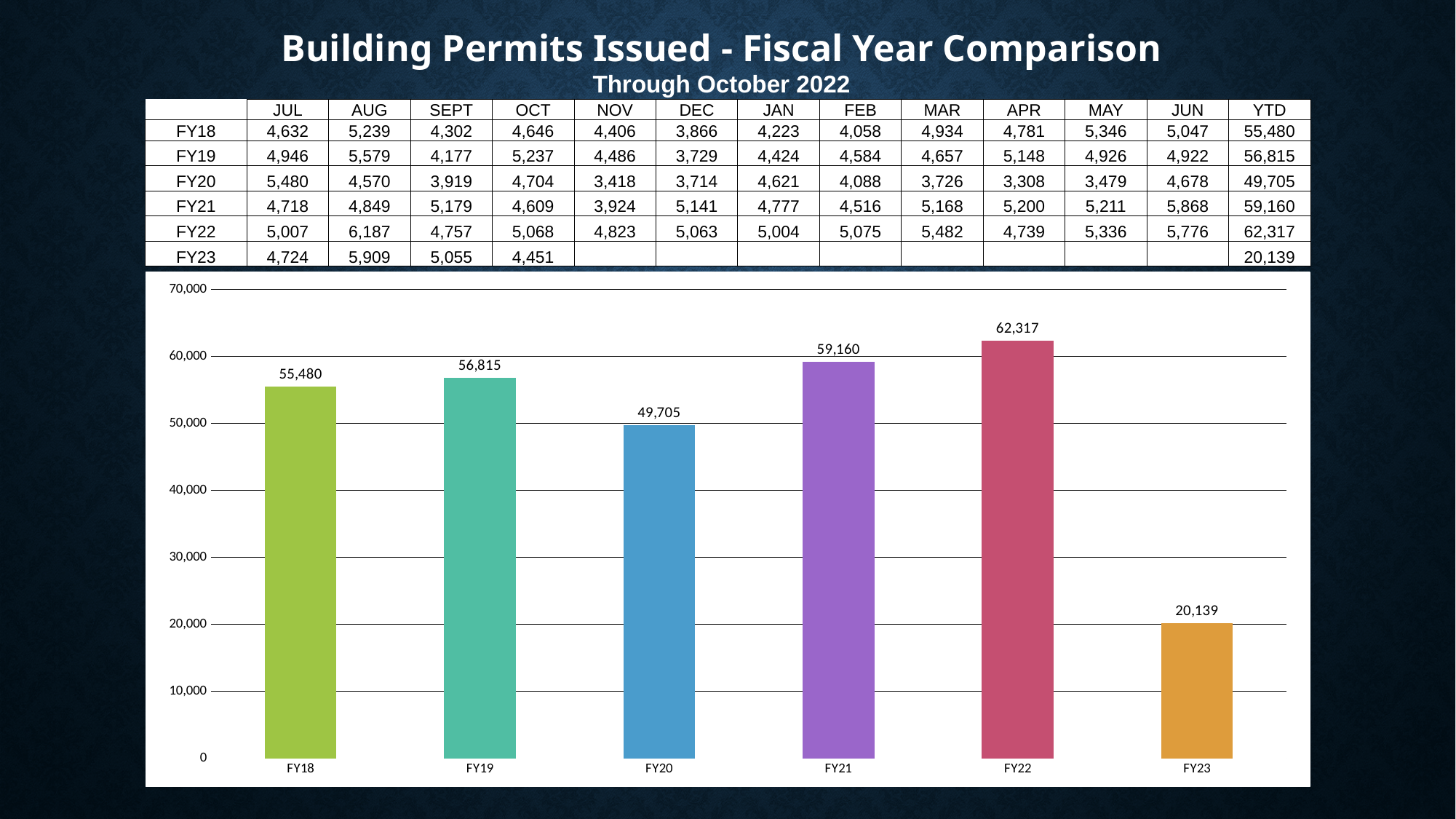
How many fiscal years are plotted as bars in the chart? 6 What is the value of the bar for FY23? 20,139 What is the difference between the FY19 and FY18 bar values? 1,335 What is the value of the bar for FY22? 62,317 Is the value for FY20 greater or less than 50,000? less What is the value of the bar for FY20? 49,705 Which is larger, the bar for FY21 or the bar for FY20? FY21 What is the title of the slide containing the chart? Building Permits Issued - Fiscal Year Comparison What is the difference between the FY22 and FY21 bar values? 3,157 Which fiscal year has the highest bar in the chart? FY22 Which fiscal year has the lowest bar in the chart? FY23 What kind of chart is shown on the slide? bar chart